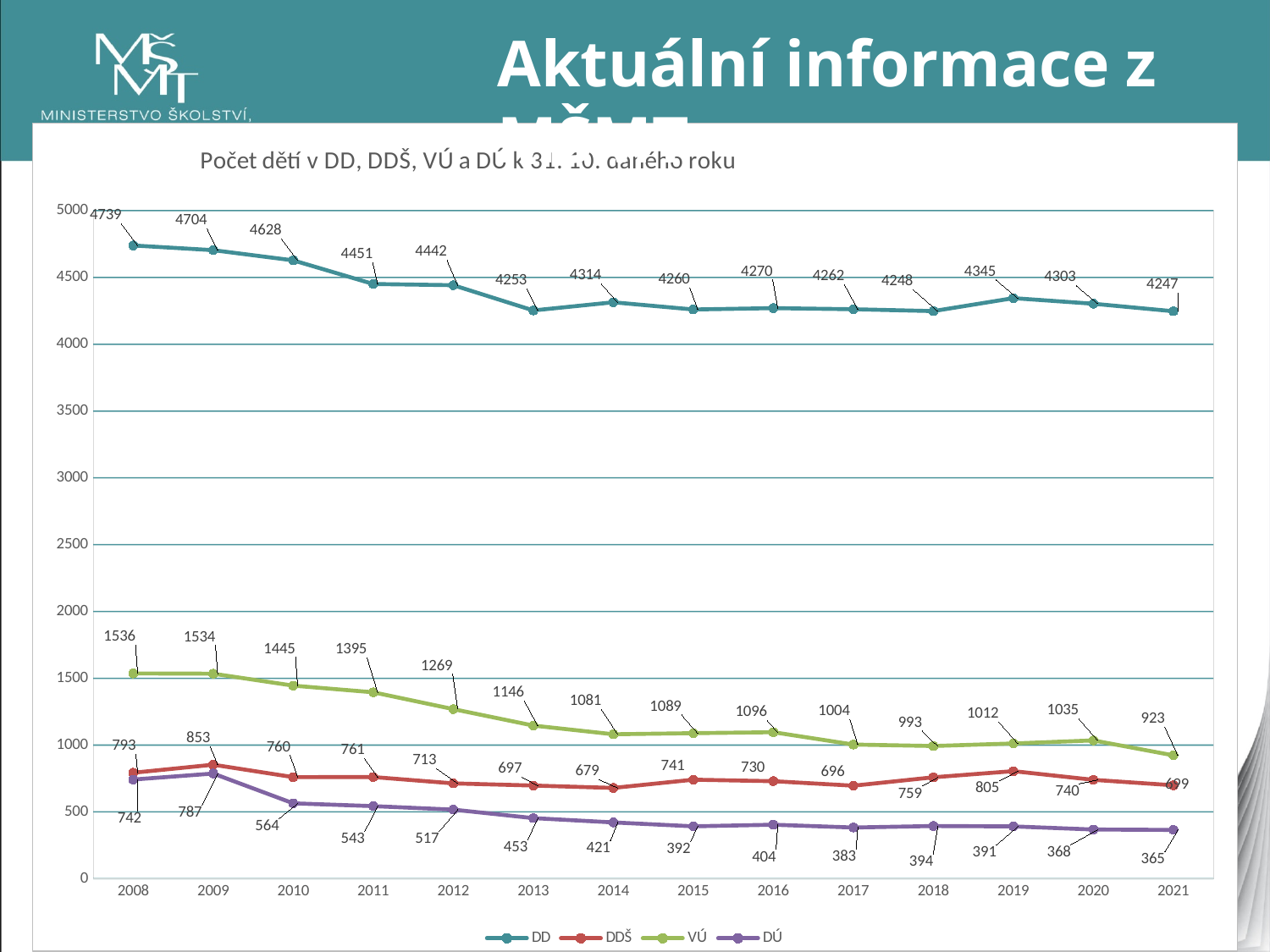
What is the value for VÚ in 2021? 923 How many years are shown on the x axis? 14 What is the value for DDŠ in 2019? 805 In which year is the DÚ value lowest? 2021 What is the value for DD in 2008? 4739 Does the VÚ series generally rise or fall from 2008 to 2021? fall What type of chart is shown on the slide? line chart Which is larger in 2009, the DDŠ value or the DÚ value? DDŠ What is the value for DÚ in 2010? 564 What is the difference between the VÚ values in 2008 and 2021? 613 In which year is the DD value highest? 2008 How many series does the legend list? 4